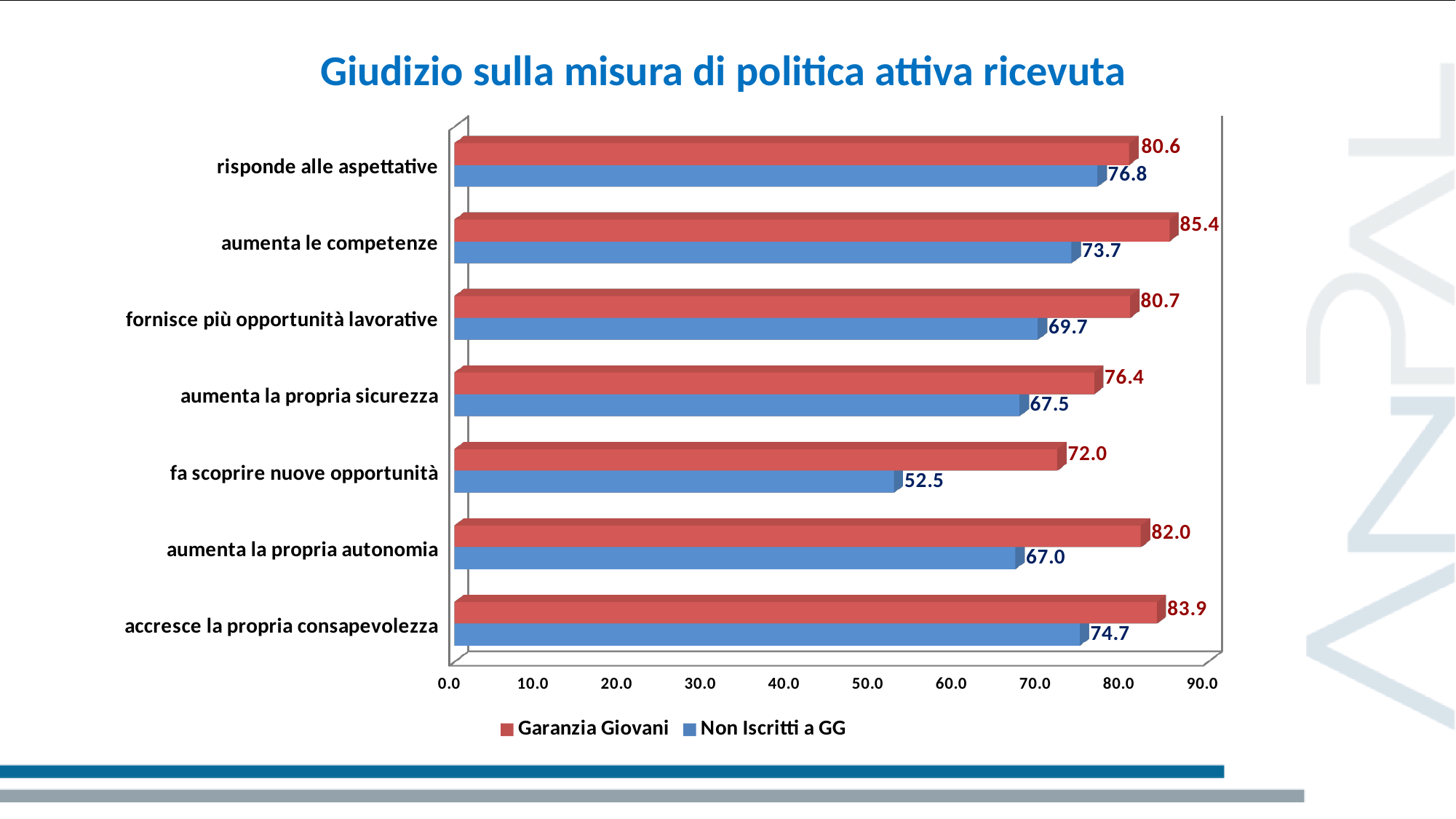
Which category has the highest value for Garanzia Giovani? aumenta le competenze What is the value for Non Iscritti a GG on 'fa scoprire nuove opportunità'? 52.5 What is the difference between Garanzia Giovani and Non Iscritti a GG on 'fa scoprire nuove opportunità'? 19.5 Which category has the lowest value for Non Iscritti a GG? fa scoprire nuove opportunità How many categories are shown on the chart? 7 What is the difference between Garanzia Giovani and Non Iscritti a GG on 'aumenta la propria autonomia'? 15.0 How many series does the legend list? 2 Is the value for Non Iscritti a GG on 'aumenta la propria sicurezza' greater or less than 70.0? less What is the value for Non Iscritti a GG on 'risponde alle aspettative'? 76.8 Which series has the larger value on 'accresce la propria consapevolezza'? Garanzia Giovani What kind of chart is shown on the slide? bar chart What is the value for Garanzia Giovani on 'aumenta le competenze'? 85.4